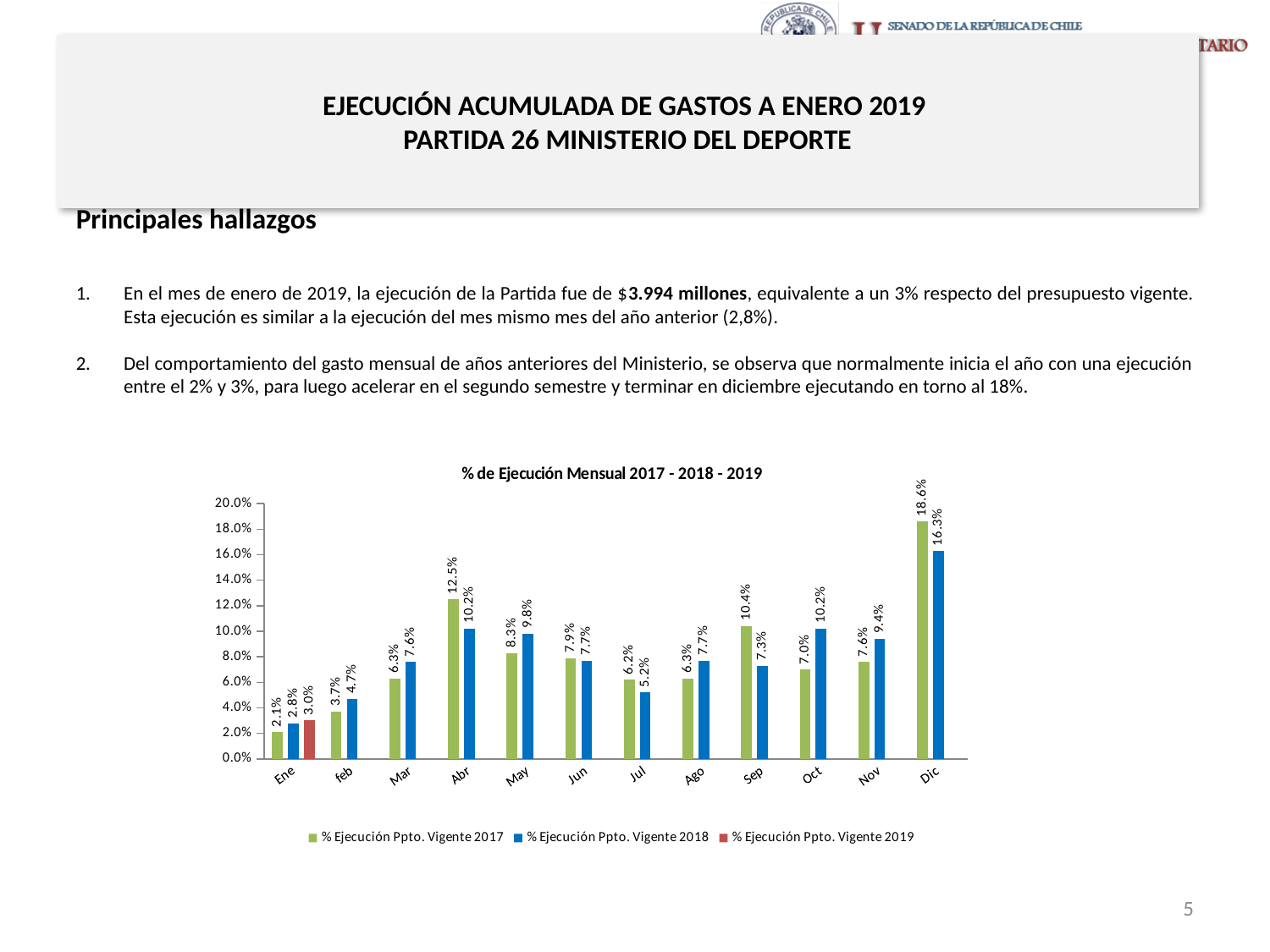
Which month has the highest value in the % Ejecución Ppto. Vigente 2018 series? Dic What is the value for Oct in the % Ejecución Ppto. Vigente 2018 series? 10.2% What is the value for Ene in the % Ejecución Ppto. Vigente 2019 series? 3.0% What is the title of the chart? % de Ejecución Mensual 2017 - 2018 - 2019 What is the value for Abr in the % Ejecución Ppto. Vigente 2017 series? 12.5% How many months are shown on the x axis? 12 What is the difference between the 2017 and 2018 values for Dic? 2.3% For Sep, which series has the larger value, 2017 or 2018? 2017 What kind of chart is shown on the slide? Bar chart Which month has the lowest value in the % Ejecución Ppto. Vigente 2017 series? Ene How many series does the legend list? 3 Is the value for Abr in the 2017 series greater or less than 10.0%? greater